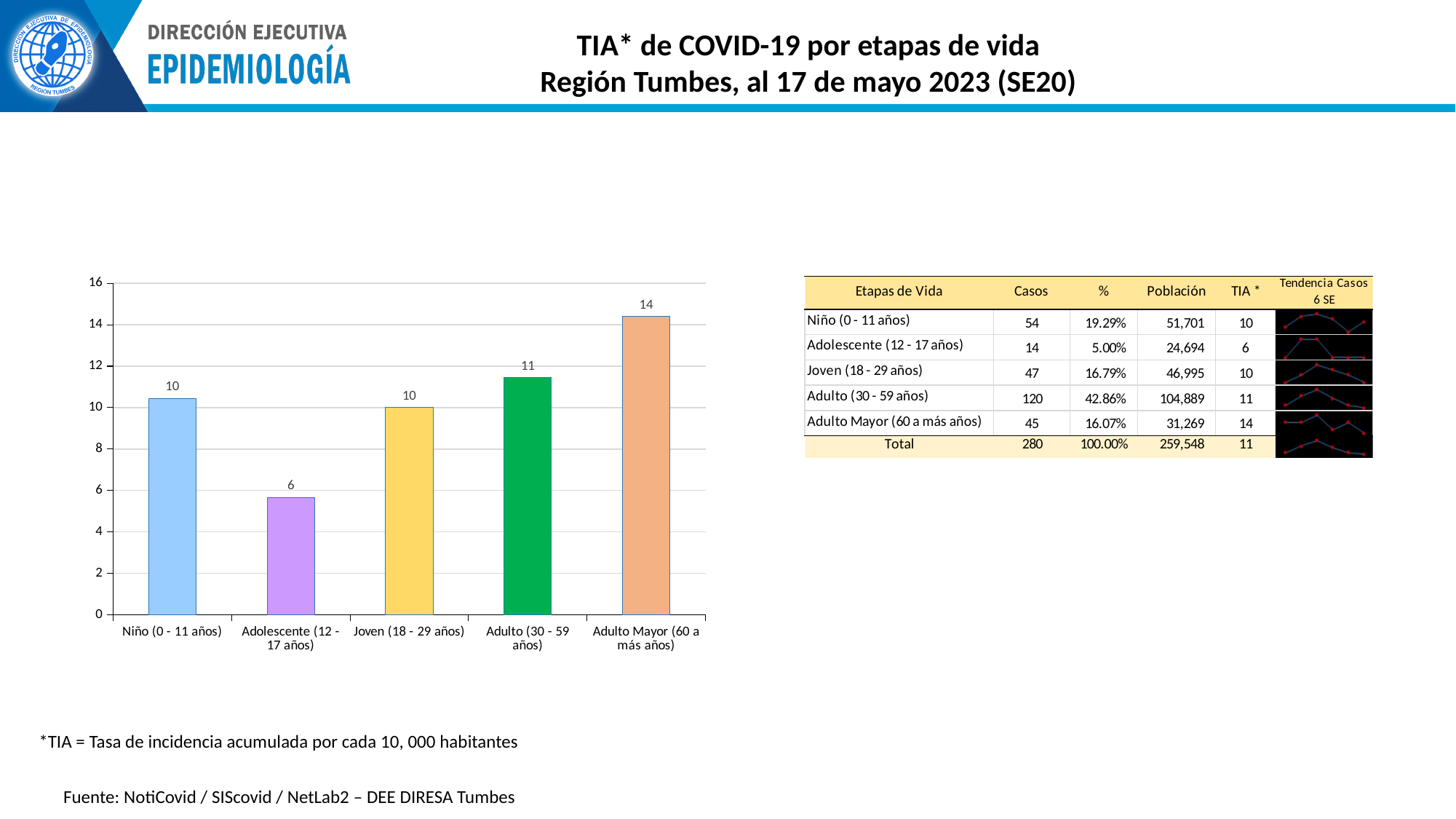
Which life stage has the highest TIA in the bar chart? Adulto Mayor (60 a más años) What is the maximum value shown on the vertical axis of the bar chart? 16 What is the TIA value shown for Adolescente (12 - 17 años) in the bar chart? 6 What is the TIA value shown for Niño (0 - 11 años) in the bar chart? 10 How many life-stage categories are plotted in the bar chart? 5 What is the difference between the TIA labels for Adulto Mayor (60 a más años) and Adolescente (12 - 17 años)? 8 What type of chart is used to show TIA by life stage? Bar chart What is the TIA value shown for Adulto (30 - 59 años) in the bar chart? 11 Which has a larger TIA in the bar chart, Adulto (30 - 59 años) or Adolescente (12 - 17 años)? Adulto (30 - 59 años) Is the bar for Adulto Mayor (60 a más años) greater or less than 12 on the axis? greater Which life stage has the lowest TIA in the bar chart? Adolescente (12 - 17 años) What is the TIA value shown for Adulto Mayor (60 a más años) in the bar chart? 14